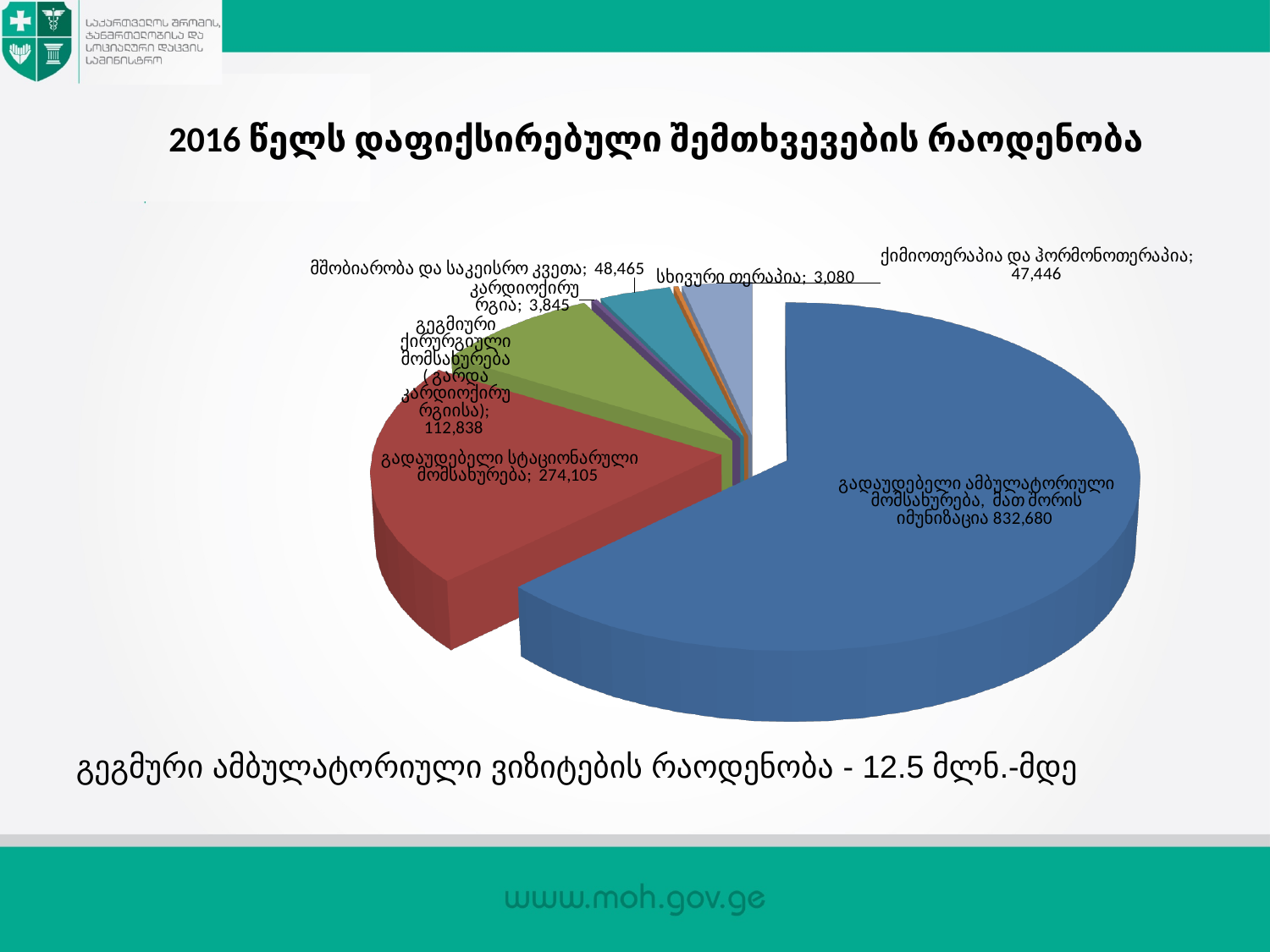
What is the value for მშობიარობა და საკეისრო კვეთა? 48,465 What is the difference between the values for გადაუდებელი სტაციონარული მომსახურება and გეგმიური ქირურგიული მომსახურება (გარდა კარდიოქირურგიისა)? 161,267 What kind of chart is shown on the slide? pie chart What is the value for კარდიოქირურგია? 3,845 What is the value for სხივური თერაპია? 3,080 What is the value for ქიმიოთერაპია და ჰორმონოთერაპია? 47,446 How many slices does the pie chart have? 7 Which is larger, the value for მშობიარობა და საკეისრო კვეთა or the value for ქიმიოთერაპია და ჰორმონოთერაპია? მშობიარობა და საკეისრო კვეთა Which category has the largest slice of the pie? გადაუდებელი ამბულატორიული მომსახურება, მათ შორის იმუნიზაცია Which category has the smallest slice of the pie? სხივური თერაპია What is the value for გადაუდებელი სტაციონარული მომსახურება? 274,105 What is the title of the chart? 2016 წელს დაფიქსირებული შემთხვევების რაოდენობა